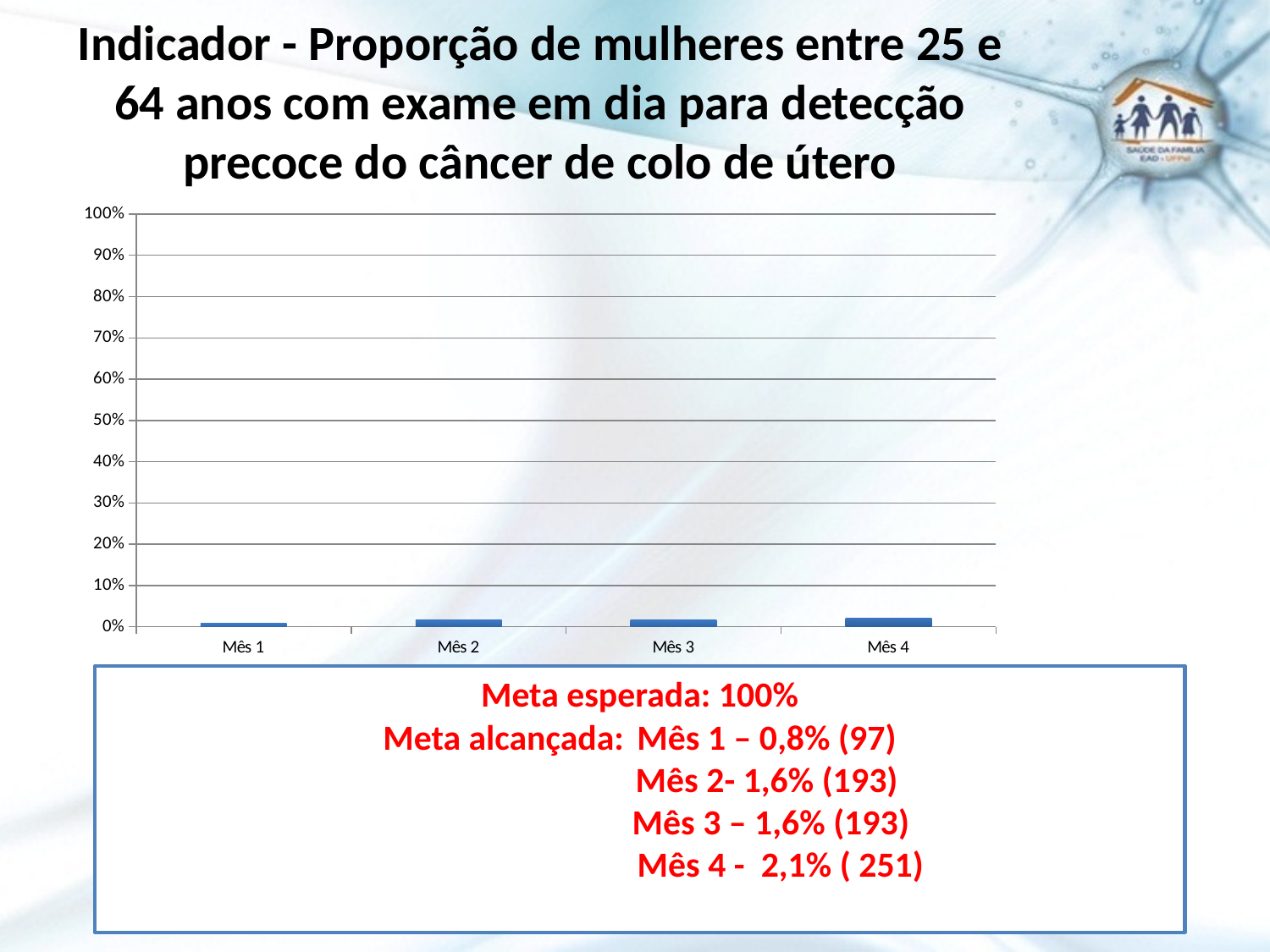
Do the bar values rise or fall from Mês 1 to Mês 4? rise What kind of chart is shown on the slide? bar chart Which month has the lowest bar in the chart? Mês 1 Which is larger, the value for Mês 1 or the value for Mês 4? Mês 4 What is the expected target (meta esperada) stated on the slide? 100% How many months (categories) are plotted on the x axis of the chart? 4 What is the difference between the proportion achieved in Mês 4 and in Mês 1? 1,3% According to the slide, what proportion was achieved in Mês 4? 2,1% According to the slide, what proportion was achieved in Mês 1? 0,8% Is the value for Mês 4 greater or less than 10%? less Is the value for Mês 1 greater or less than 10%? less Which month has the highest bar in the chart? Mês 4